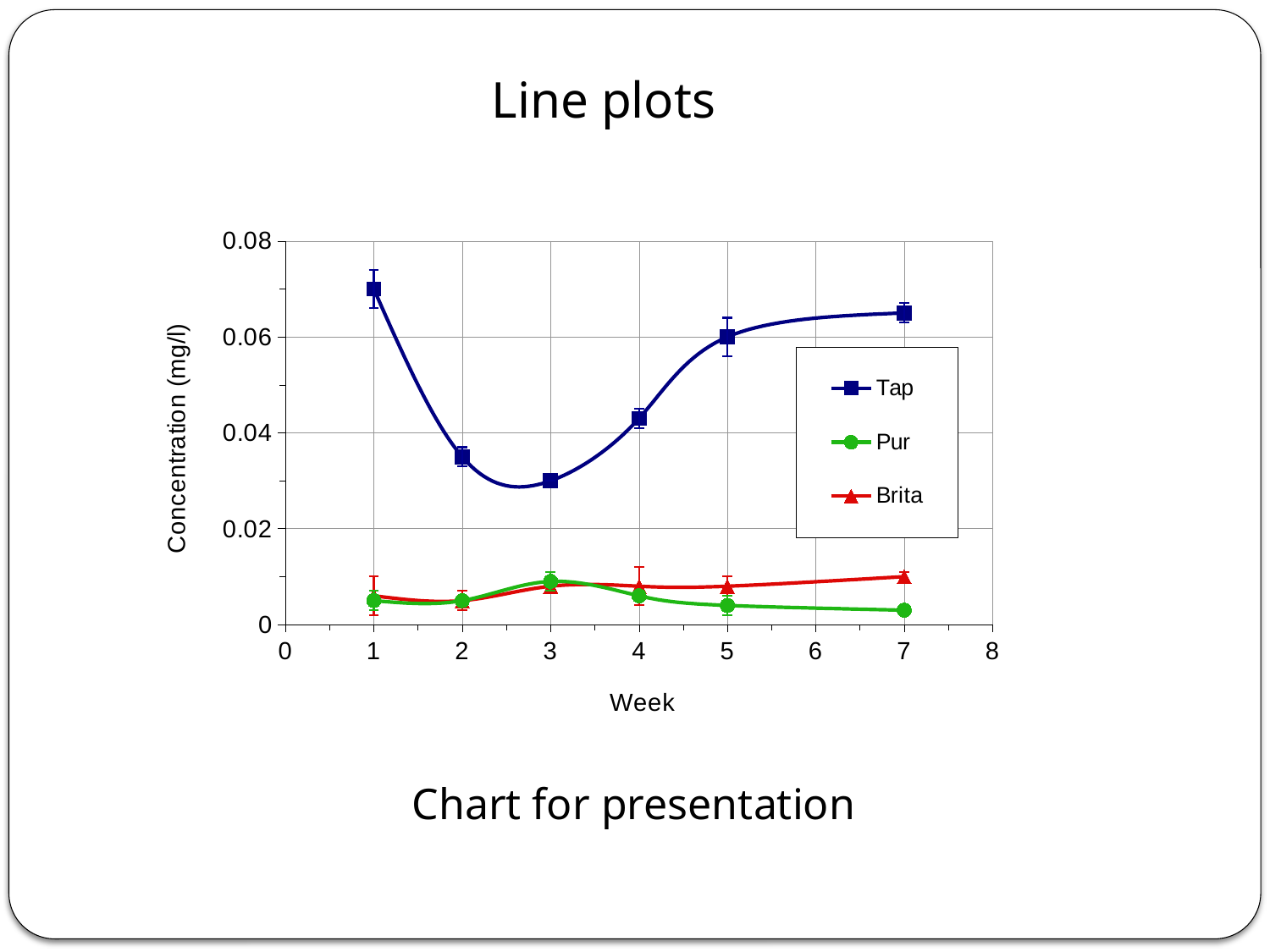
At week 4, which series has the larger value, Tap or Pur? Tap Which series has the highest values across all weeks? Tap What is the label of the x axis? Week Is the value for Pur at week 7 greater or less than 0.02? less How many data points are plotted for the Tap series? 6 Is the value for Tap at week 1 greater or less than 0.06? greater Is the value for Tap at week 5 greater or less than 0.04? greater How many series does the legend list? 3 What kind of chart is shown on the slide? line chart Do the Tap values rise or fall from week 3 to week 7? rise What is the label of the y axis? Concentration (mg/l)